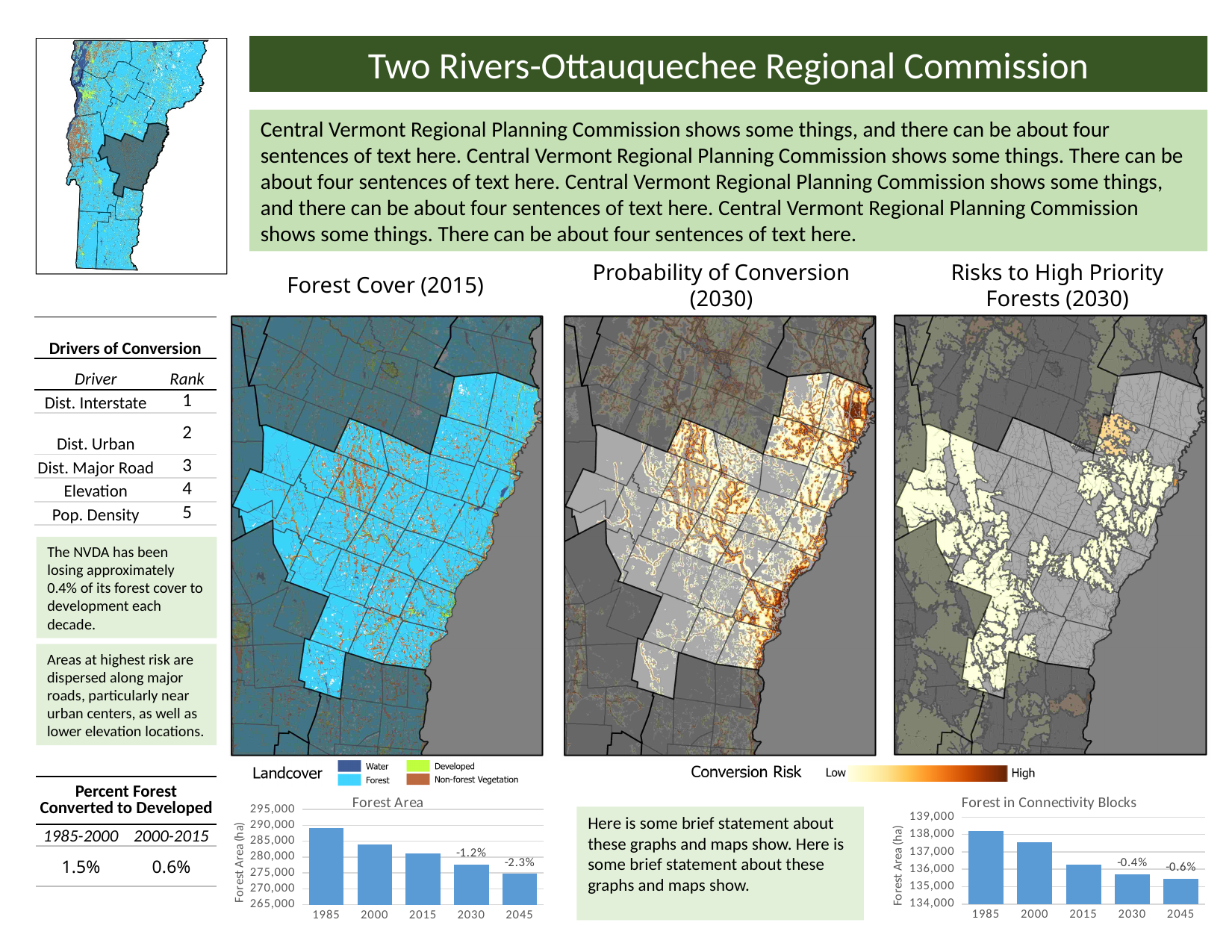
In the "Forest in Connectivity Blocks" chart, what percentage label is shown above the 2030 bar? -0.4% In the "Forest in Connectivity Blocks" chart, is the value for 2045 greater or less than 136,000? less In the "Forest Area" chart, which year has the highest forest area? 1985 In the "Forest in Connectivity Blocks" chart, which year has the highest value? 1985 In the "Forest Area" chart, what percentage label is shown above the 2030 bar? -1.2% In the "Forest Area" chart, which year has the lowest forest area? 2045 What kind of chart is the "Forest Area" chart? bar chart In the "Forest Area" chart, do the values rise or fall from 1985 to 2045? fall What is the y-axis label of the "Forest in Connectivity Blocks" chart? Forest Area (ha) How many years are shown on the x axis of the "Forest Area" chart? 5 In the "Forest Area" chart, what percentage label is shown above the 2045 bar? -2.3% In the "Forest Area" chart, is the value for 1985 greater or less than 285,000? greater